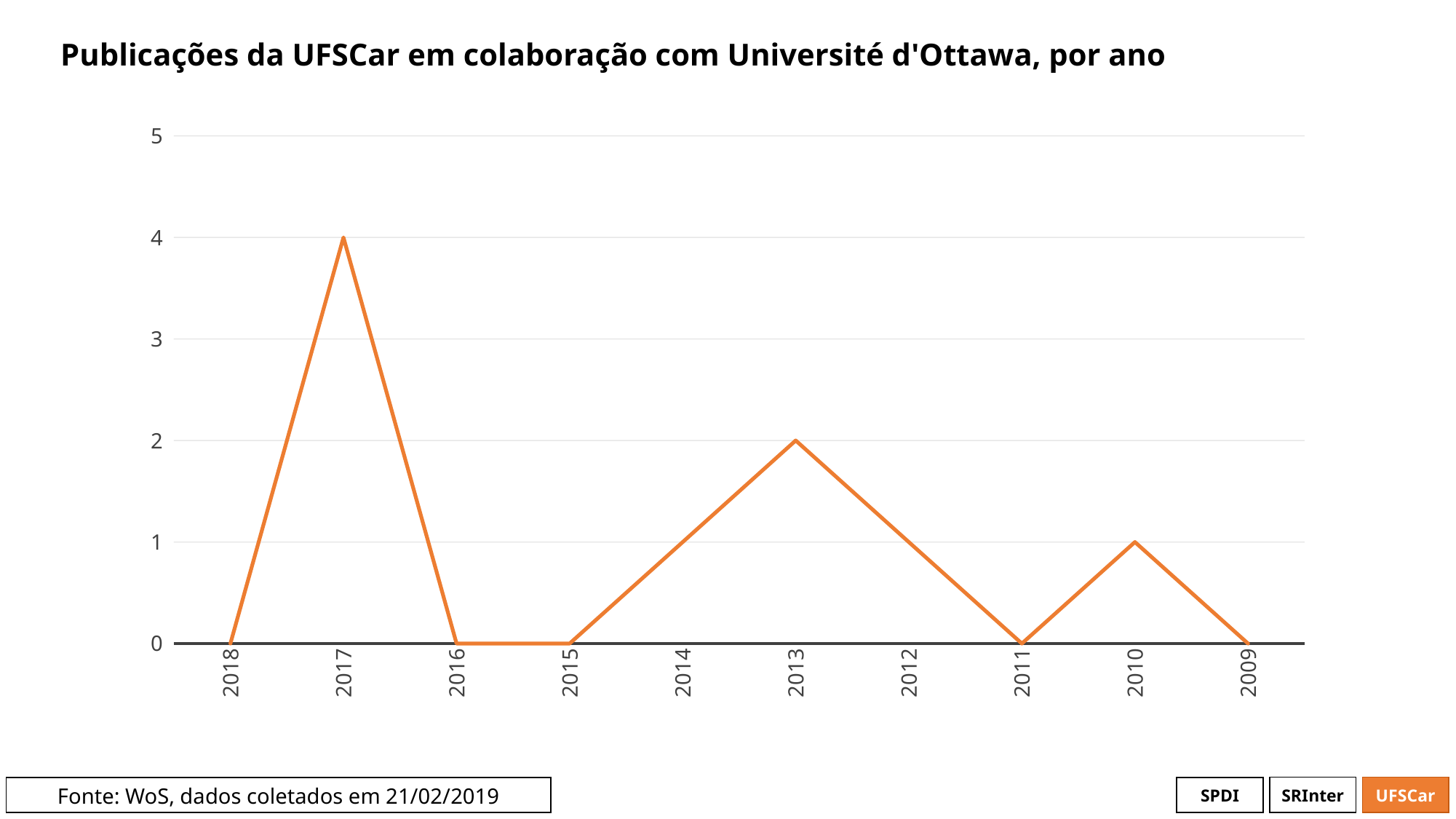
What is the value for 2010? 1 What is the title of the chart? Publicações da UFSCar em colaboração com Université d'Ottawa, por ano Which year has the highest value? 2017 What is the difference between the values for 2017 and 2013? 2 What is the value for 2013? 2 What colour is the plotted line? orange Which is larger, the value for 2013 or the value for 2010? 2013 What type of chart is shown on the slide? line chart Is the value for 2017 greater or less than 3? greater What is the value for 2017? 4 What is the value for 2018? 0 How many years are plotted on the x axis? 10